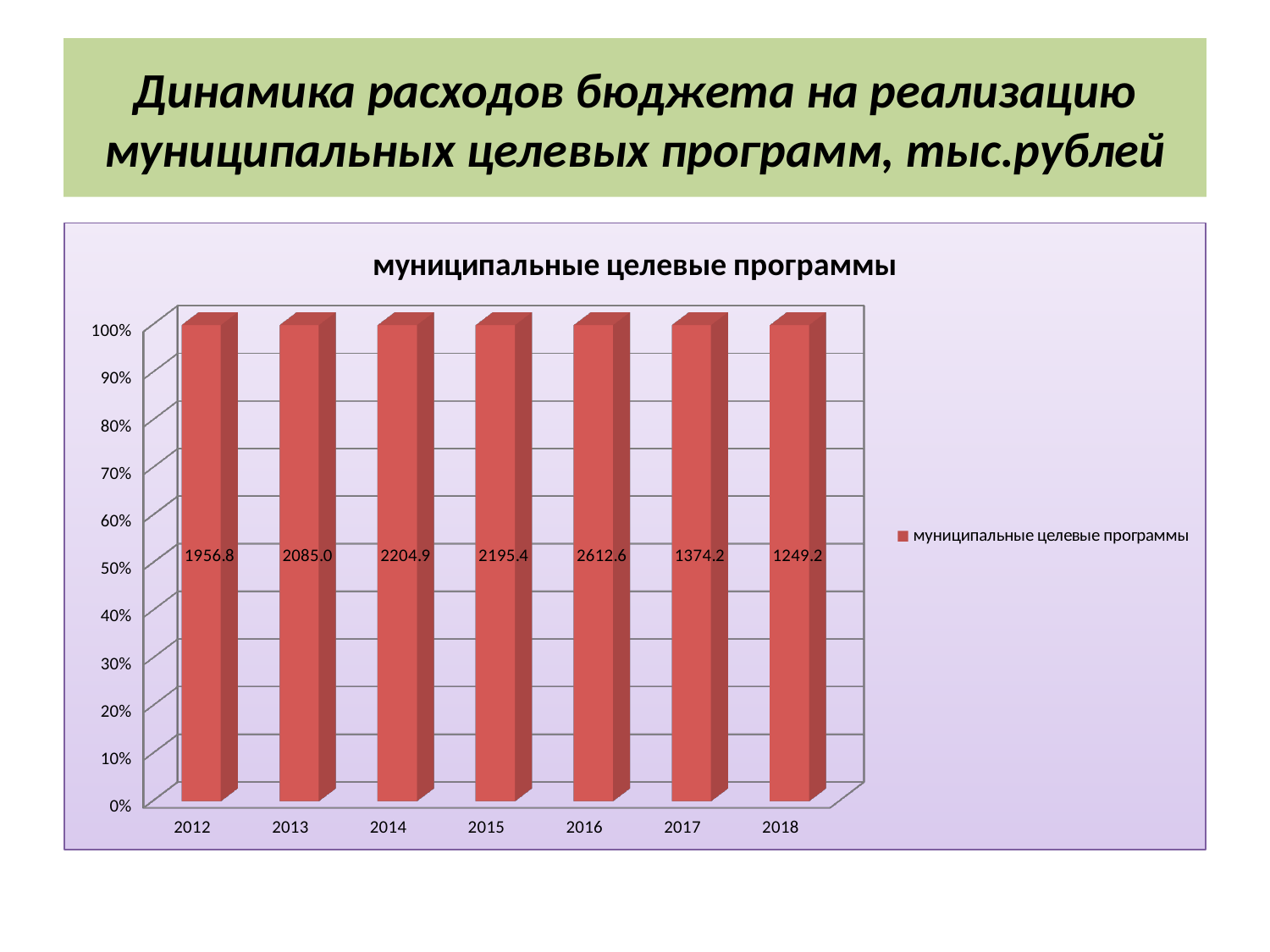
What is the data label for 2014 in the chart? 2204.9 What is the data label for 2012 in the chart? 1956.8 What type of chart is shown on the slide? Bar chart What is the data label for 2016 in the chart? 2612.6 How many years are shown on the x axis of the chart? 7 What is the difference between the labelled values for 2013 and 2012? 128.2 Which year has the lowest labelled value in the chart? 2018 What is the difference between the labelled values for 2016 and 2017? 1238.4 How many series does the legend of the chart list? 1 What is the data label for 2018 in the chart? 1249.2 Which year has the larger labelled value, 2015 or 2017? 2015 Which year has the highest labelled value in the chart? 2016